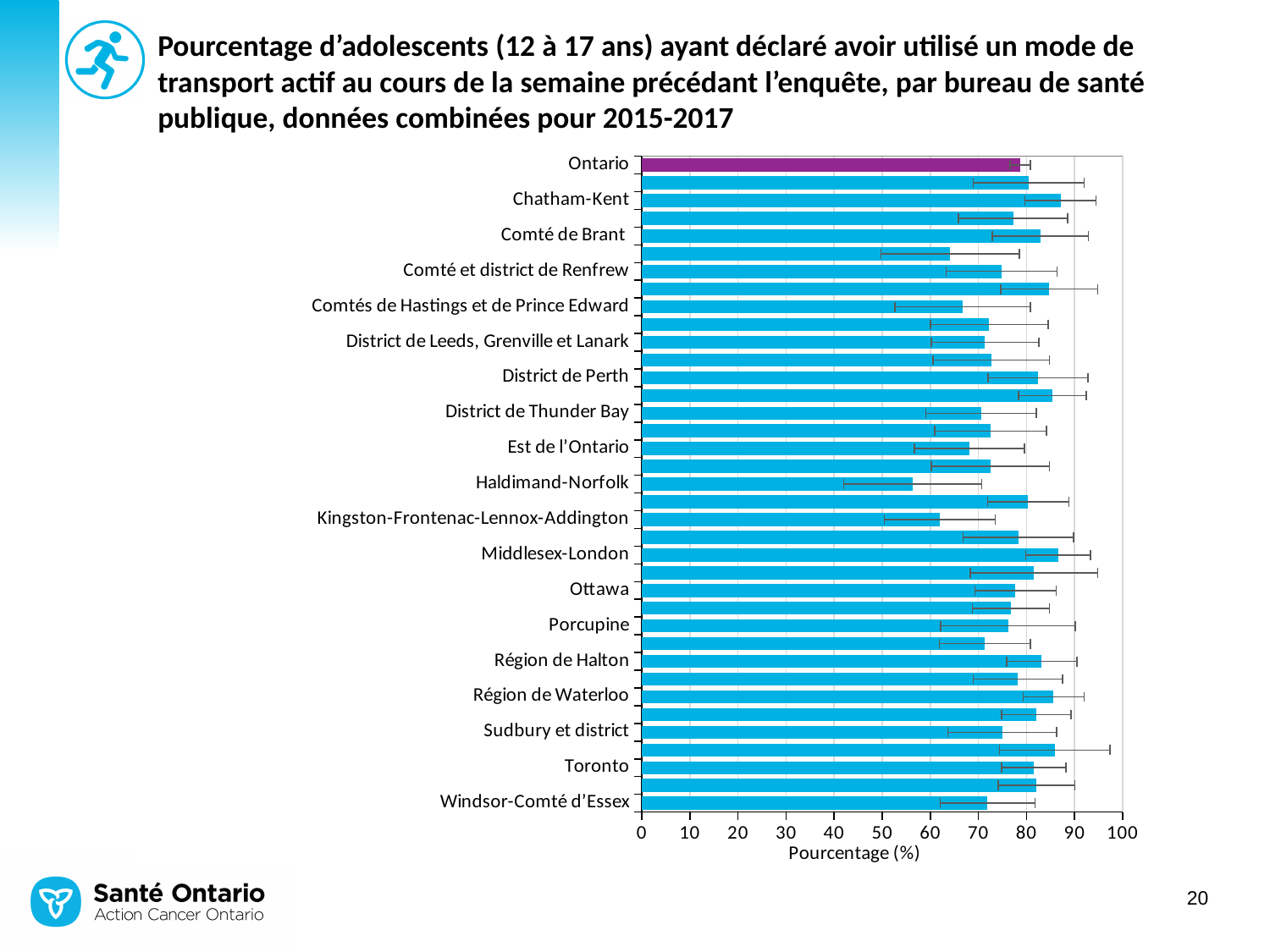
Is the value for Comtés de Hastings et de Prince Edward greater or less than 70? less Which has the larger value, Chatham-Kent or Haldimand-Norfolk? Chatham-Kent Is the value for Middlesex-London greater or less than 80? greater What kind of chart is shown on the slide? bar chart Is the value for Ontario greater or less than 70? greater Which labelled health unit has the lowest value on the chart? Haldimand-Norfolk What is the title of the x axis? Pourcentage (%)